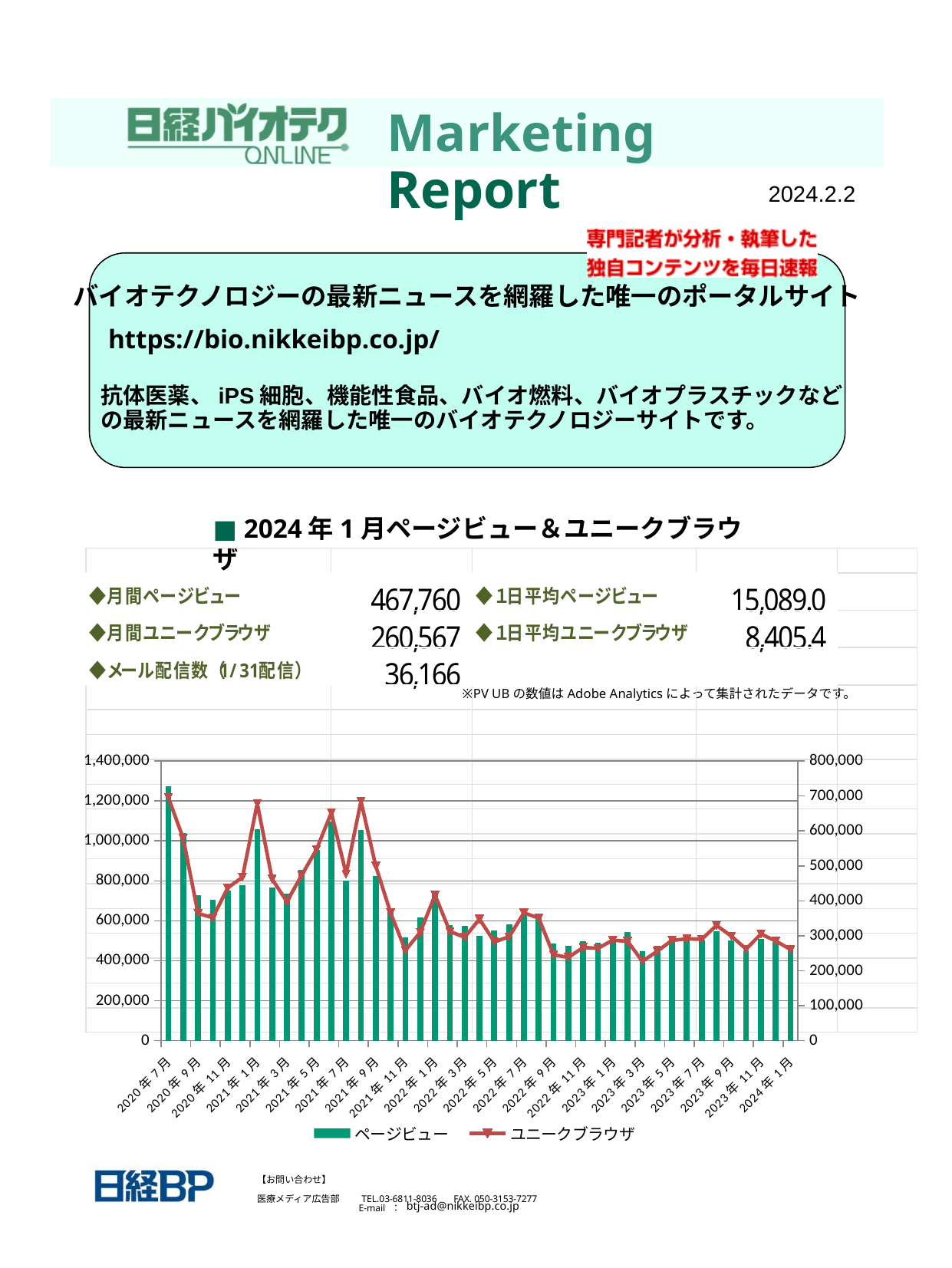
What kind of chart is shown on the slide? A combined bar and line chart Is the ユニークブラウザ value for 2024年1月 greater or less than 300,000? less Which is larger, the ユニークブラウザ value for 2021年9月 or for 2021年11月? 2021年9月 Is the ページビュー value for 2024年1月 greater or less than 600,000? less What is the title printed above the chart? 2024年1月ページビュー＆ユニークブラウザ Which month has the highest ページビュー bar? 2020年7月 Which is larger, the ページビュー value for 2020年7月 or for 2024年1月? 2020年7月 Is the ページビュー value for 2020年7月 greater or less than 1,200,000? greater What are the two series named in the chart legend? ページビュー and ユニークブラウザ Overall, do the ページビュー values rise or fall from 2020年7月 to 2024年1月? fall How many series does the chart legend list? 2